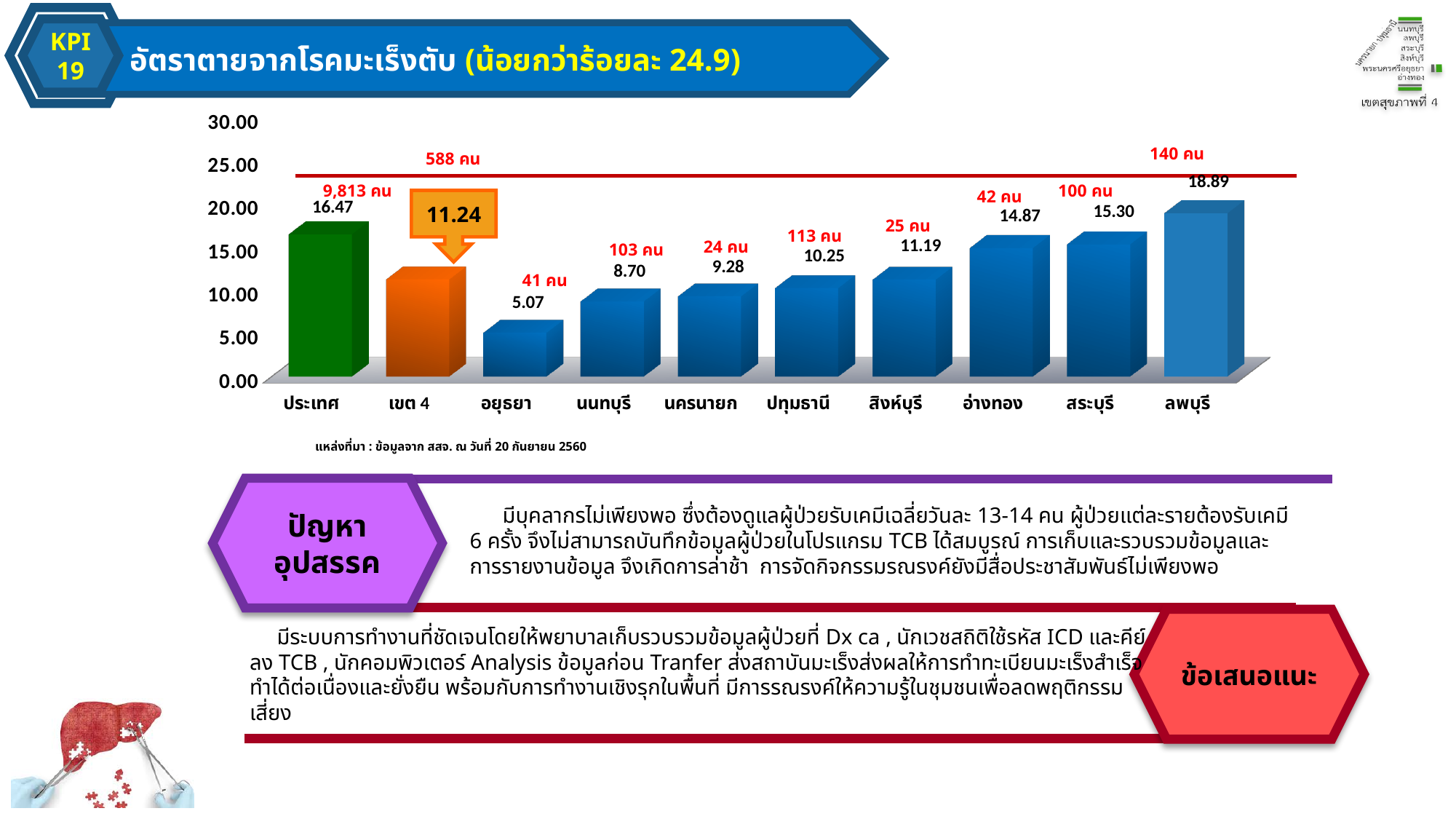
What is the value for ลพบุรี? 18.89 Which is larger, the value for สระบุรี or the value for อ่างทอง? สระบุรี What is the title of the chart? อัตราตายจากโรคมะเร็งตับ (น้อยกว่าร้อยละ 24.9) Which category has the lowest value? อยุธยา How many cases (คน) are shown above the ประเทศ bar? 9,813 คน Which category has the highest value? ลพบุรี What type of chart is shown on the slide? Bar chart What is the difference between the values for ประเทศ and เขต 4? 5.23 How many categories are shown on the x axis? 10 What is the value for เขต 4? 11.24 What is the value for อยุธยา? 5.07 Is the value for นนทบุรี greater or less than 10.00? less